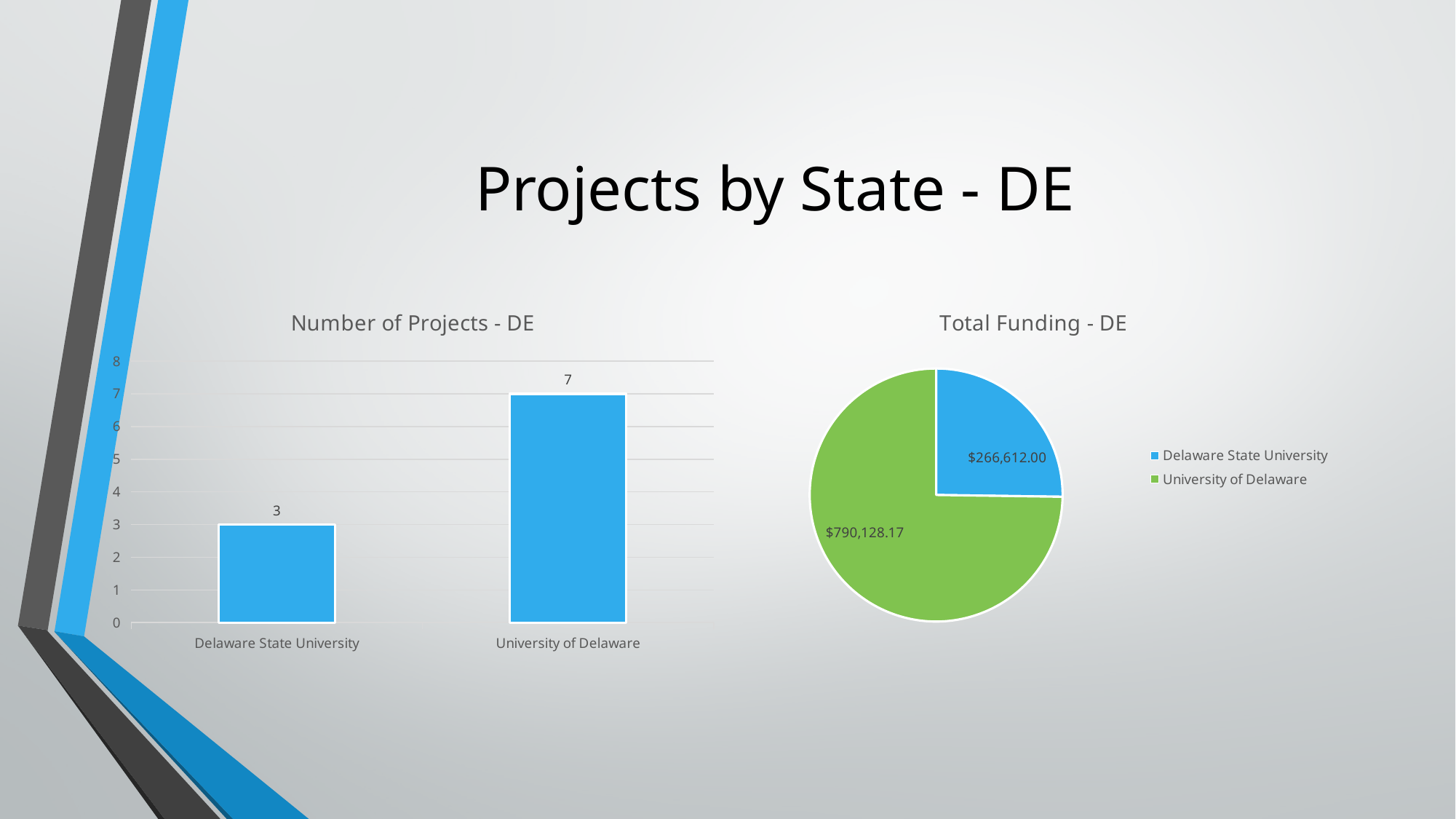
In the Total Funding - DE chart, what is the total funding for the University of Delaware? $790,128.17 In the Number of Projects - DE chart, how many projects does the University of Delaware have? 7 In the Total Funding - DE chart, which university received more funding? University of Delaware In the Number of Projects - DE chart, how many projects does Delaware State University have? 3 What kind of chart is the Total Funding - DE chart? Pie chart In the Number of Projects - DE chart, which university has the most projects? University of Delaware In the Number of Projects - DE chart, how many categories are shown on the x axis? 2 In the Number of Projects - DE chart, which university has the fewest projects? Delaware State University In the Total Funding - DE chart, what is the total funding for Delaware State University? $266,612.00 What kind of chart is the Number of Projects - DE chart? Bar chart In the Number of Projects - DE chart, how many more projects does the University of Delaware have than Delaware State University? 4 In the Total Funding - DE chart, how many entries does the legend list? 2